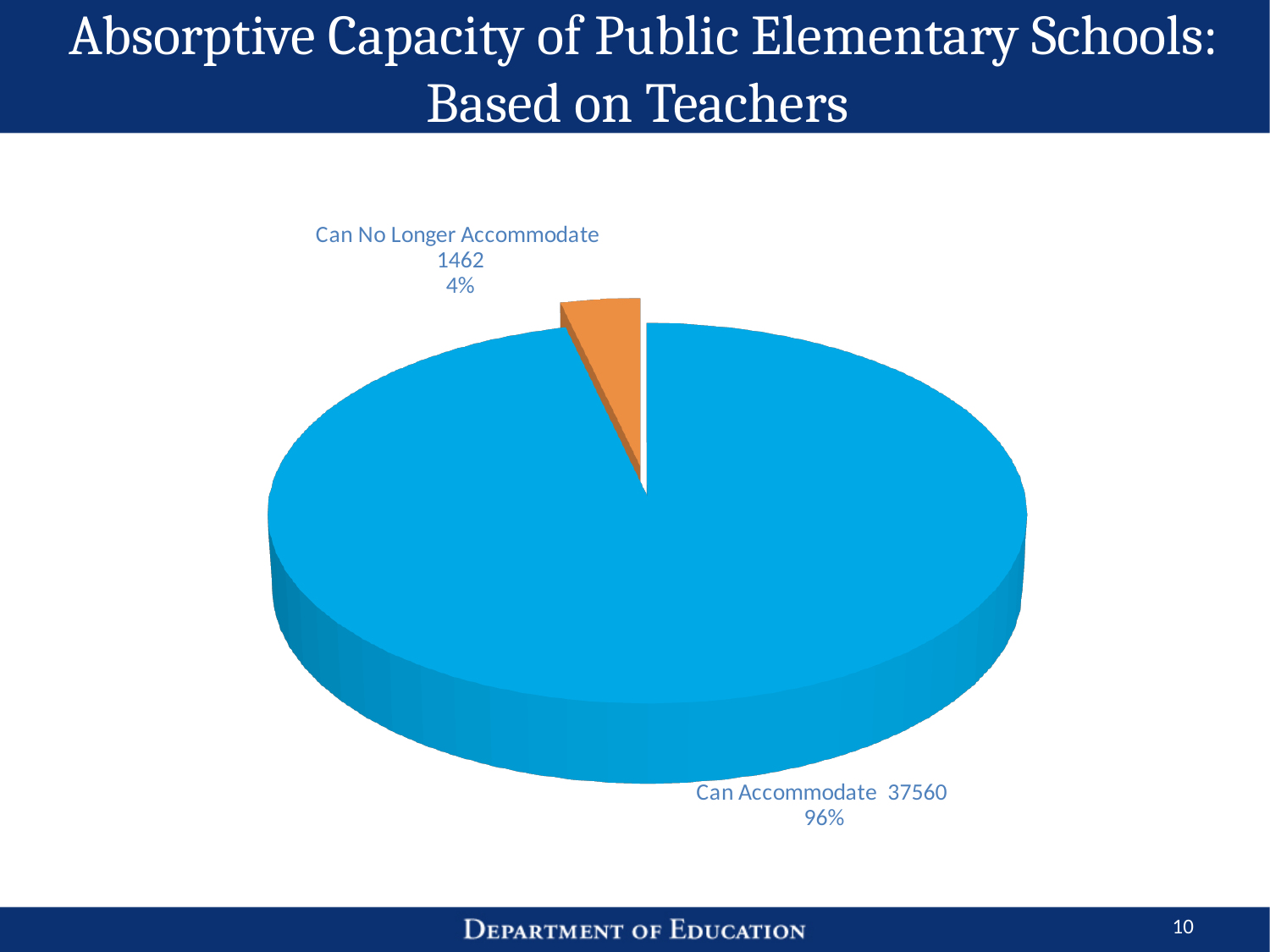
What is the difference between the values for Can Accommodate and Can No Longer Accommodate? 36098 What is the value for Can Accommodate? 37560 Which category has the smallest slice? Can No Longer Accommodate What kind of chart is shown on the slide? Pie chart What share of the pie does Can No Longer Accommodate represent? 4% Which is larger, Can Accommodate or Can No Longer Accommodate? Can Accommodate How many slices does the pie chart have? 2 What is the total of the two slices in the pie chart? 39022 What is the value for Can No Longer Accommodate? 1462 What colour is the Can No Longer Accommodate slice? Orange What share of the pie does Can Accommodate represent? 96% Which category has the largest slice? Can Accommodate